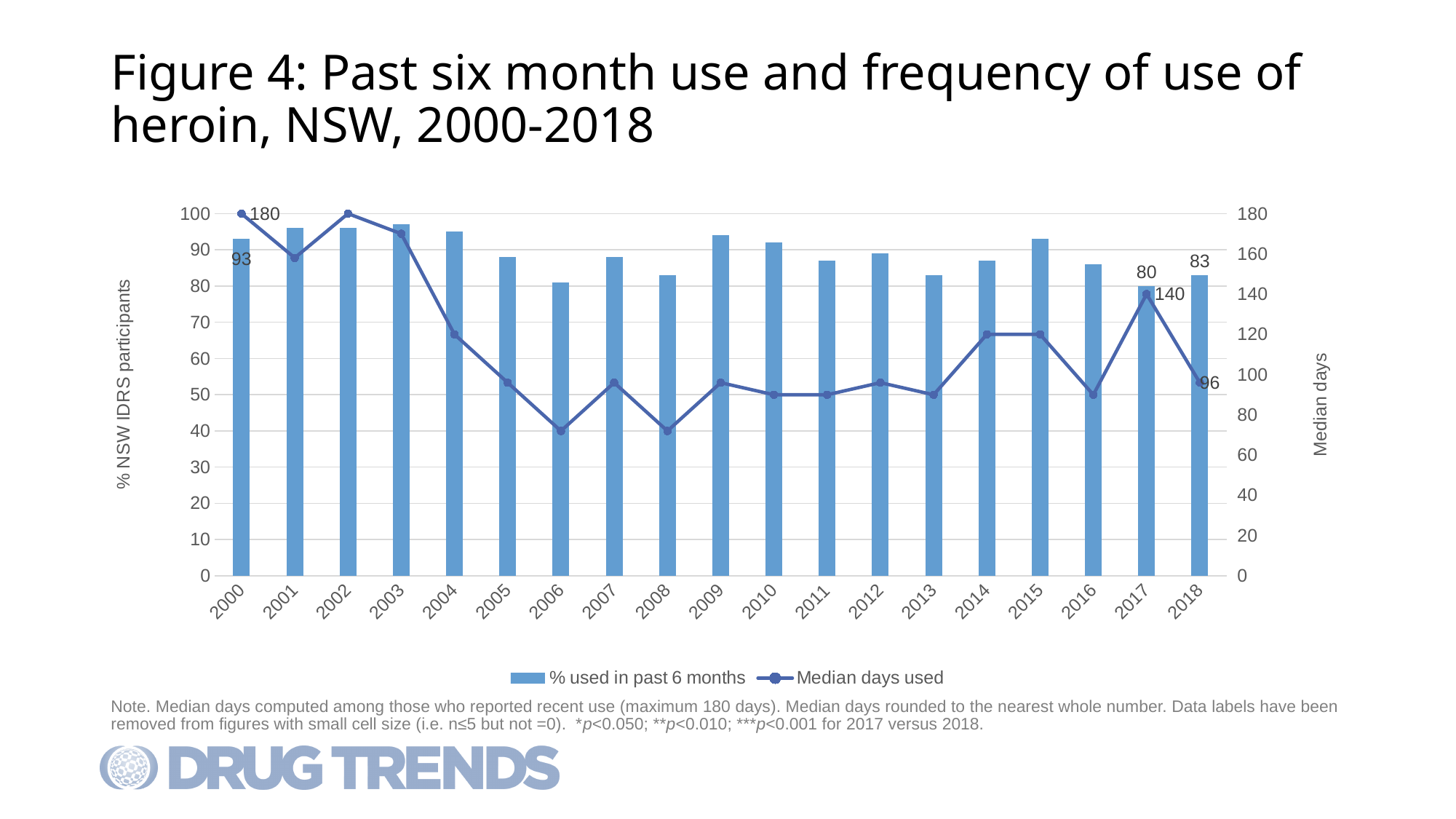
What percentage of participants reported past six month heroin use in 2017? 80 What is the difference between the percentage who used in the past 6 months in 2018 and in 2017? 3 What percentage of NSW IDRS participants reported using heroin in the past six months in 2000? 93 How many series does the legend list? 2 Is the percentage who used in the past 6 months in 2006 greater or less than 90? less How many years are shown on the x axis? 19 By how many days did the median days used fall from 2017 to 2018? 44 What kind of chart is shown on the slide? Combined bar and line chart Which year had the higher percentage of past six month use, 2017 or 2018? 2018 What was the median days used in 2017? 140 What was the median days of heroin use in 2000? 180 What was the median days used in 2018? 96